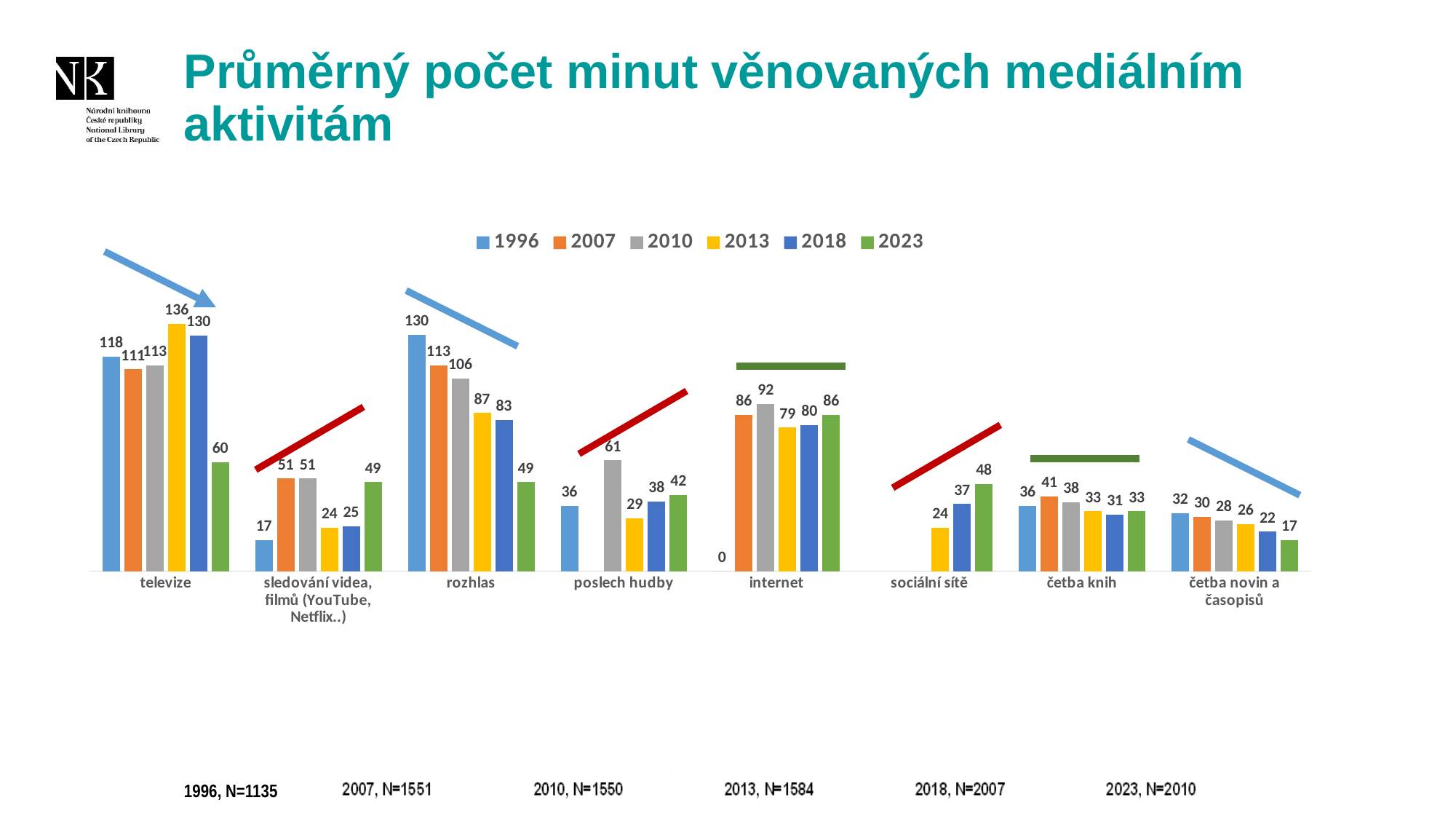
What is the difference between the 1996 and 2023 values for rozhlas? 81 How many categories are shown on the x axis? 8 Which year has the lowest value for četba novin a časopisů? 2023 What is the value for sociální sítě in 2023? 48 What is the value for internet in 2010? 92 Which year has the highest value for televize? 2013 What is the value for rozhlas in 1996? 130 How many series does the legend list? 6 What type of chart is shown on the slide? bar chart What is the value for televize in 2013? 136 Do the values for četba novin a časopisů rise or fall from 1996 to 2023? fall Which is larger for četba knih: the 2007 value or the 2018 value? 2007